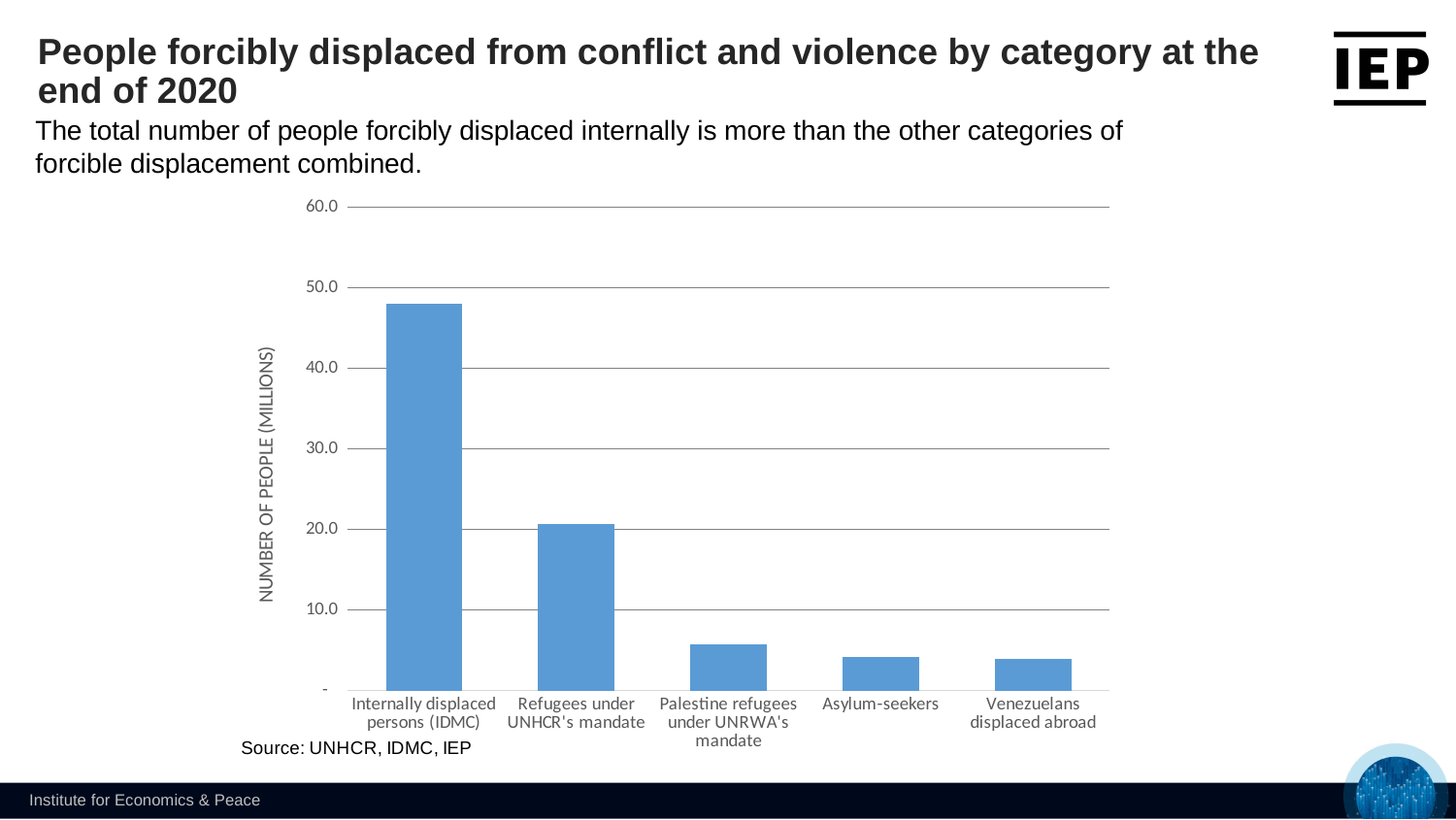
Is the value for Internally displaced persons (IDMC) greater or less than 50.0? less What is the label of the vertical axis? NUMBER OF PEOPLE (MILLIONS) Which is larger: the value for Internally displaced persons (IDMC) or the value for Refugees under UNHCR's mandate? Internally displaced persons (IDMC) How many categories of forcibly displaced people are shown on the chart? 5 What sources are cited for the chart? UNHCR, IDMC, IEP Is the value for Asylum-seekers greater or less than 10.0? less Is the value for Palestine refugees under UNRWA's mandate greater or less than 10.0? less Which category has the highest number of people? Internally displaced persons (IDMC) Which is larger: the value for Refugees under UNHCR's mandate or the value for Palestine refugees under UNRWA's mandate? Refugees under UNHCR's mandate What kind of chart is shown on the slide? bar chart